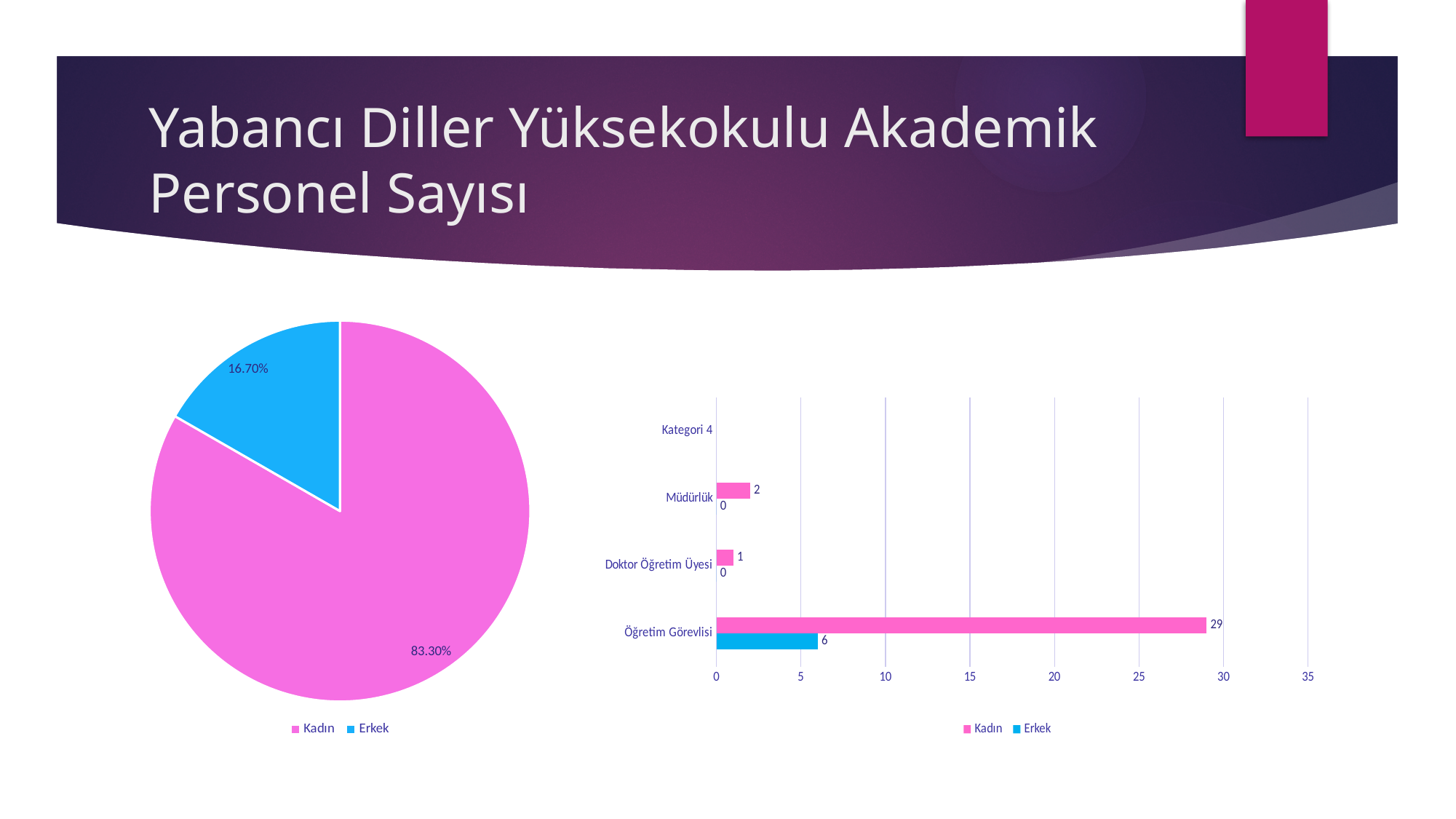
In the bar chart on the right, what is the Kadın value for Öğretim Görevlisi? 29 In the pie chart on the left, what share does Kadın have? 83.30% In the bar chart on the right, which category has the highest Kadın value? Öğretim Görevlisi What kind of chart is the chart on the left of the slide? Pie chart What kind of chart is the chart on the right of the slide? Bar chart In the pie chart on the left, which slice is larger, Kadın or Erkek? Kadın In the bar chart on the right, what is the Erkek value for Öğretim Görevlisi? 6 In the pie chart on the left, what share does Erkek have? 16.70% How many series does the legend of the bar chart on the right list? 2 In the bar chart on the right, what is the difference between the Kadın and Erkek values for Öğretim Görevlisi? 23 In the bar chart on the right, what is the Erkek value for Doktor Öğretim Üyesi? 0 In the bar chart on the right, what is the Kadın value for Müdürlük? 2